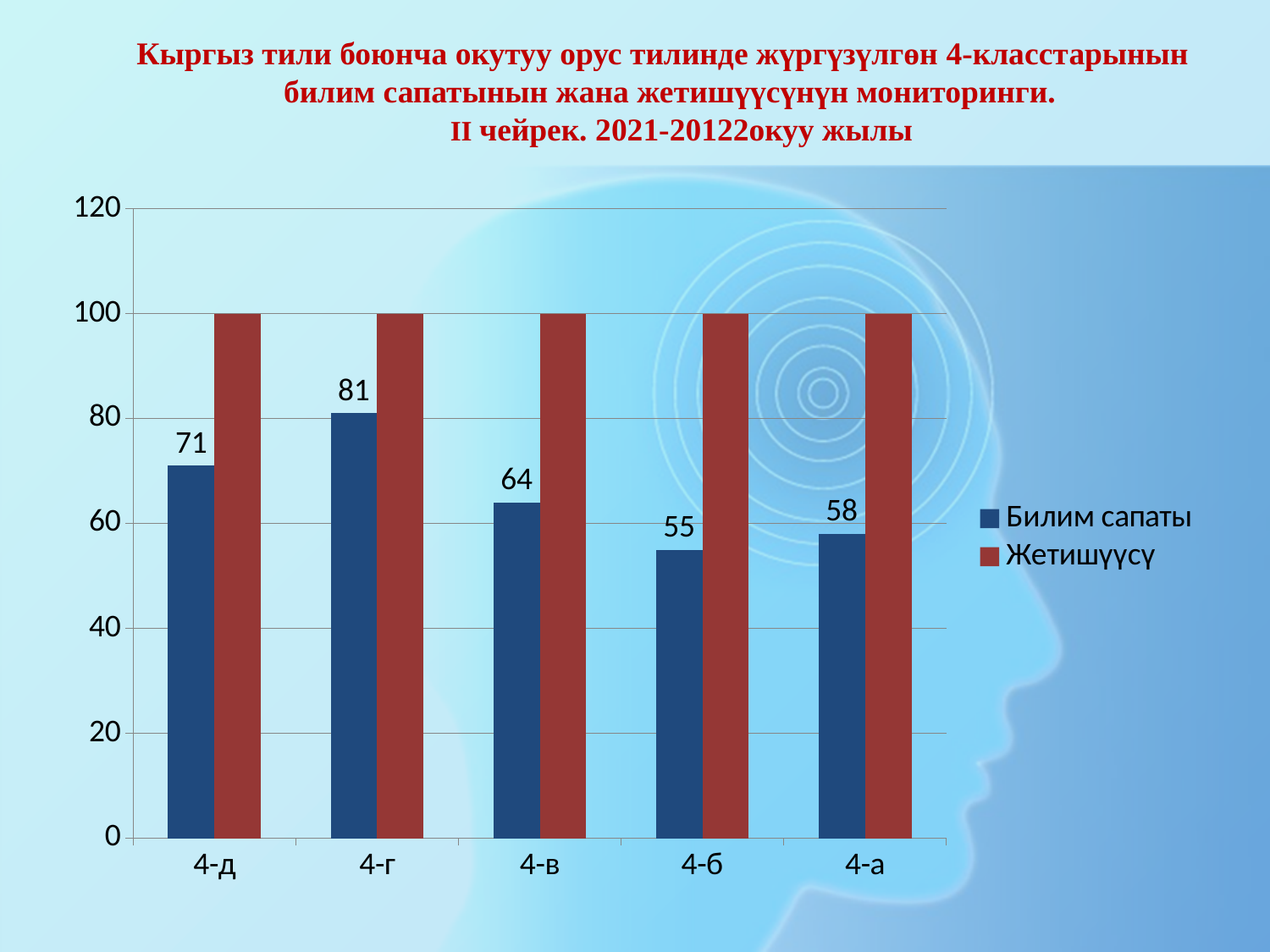
Which class has the highest Билим сапаты value? 4-г What is the value of Билим сапаты for 4-г? 81 What is the value of Билим сапаты for 4-д? 71 What is the difference between the Билим сапаты values for 4-г and 4-б? 26 Which class has the lowest Билим сапаты value? 4-б Which is larger, the Билим сапаты value for 4-в or for 4-а? 4-в Is the Билим сапаты value for 4-д greater or less than 60? greater What is the value of Билим сапаты for 4-б? 55 What kind of chart is shown on the slide? bar chart How many classes are shown on the x axis? 5 What is the value of Жетишүүсү for 4-в? 100 How many series does the legend list? 2